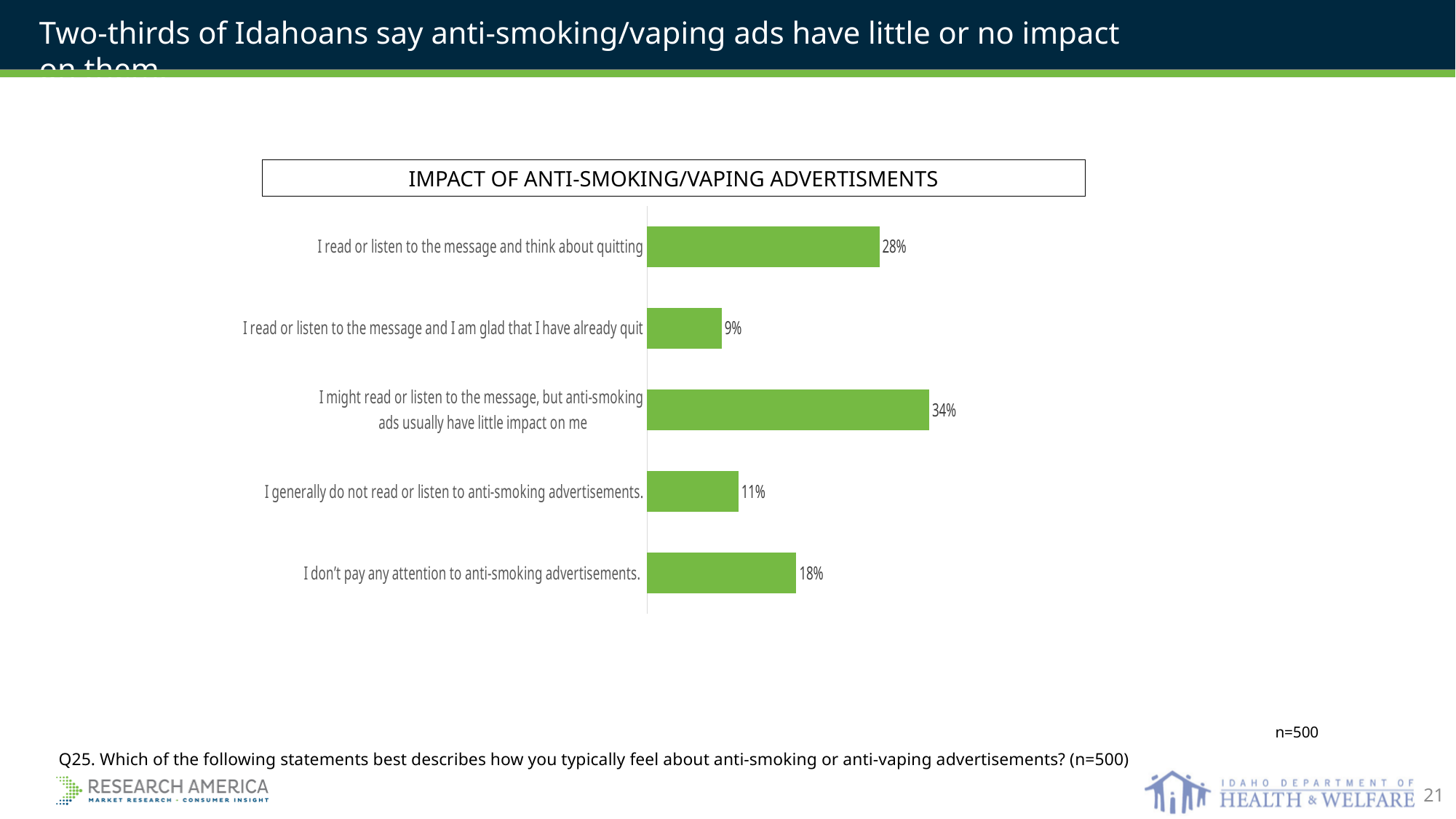
What percentage of respondents say they might read or listen to the message, but anti-smoking ads usually have little impact on them? 34% What is the title of the chart? IMPACT OF ANTI-SMOKING/VAPING ADVERTISMENTS Which statement has the highest percentage of respondents? I might read or listen to the message, but anti-smoking ads usually have little impact on me Which is larger: the percentage who don't pay any attention to anti-smoking advertisements or the percentage who generally do not read or listen to them? I don't pay any attention to anti-smoking advertisements. How many statements (categories) are shown in the chart? 5 Which statement has the lowest percentage of respondents? I read or listen to the message and I am glad that I have already quit What percentage of respondents say they read or listen to the message and are glad they have already quit? 9% What percentage of respondents say they generally do not read or listen to anti-smoking advertisements? 11% What percentage of respondents say they don't pay any attention to anti-smoking advertisements? 18% What percentage of respondents say they read or listen to the message and think about quitting? 28% What is the difference in percentage points between those who say ads have little impact on them (34%) and those who think about quitting (28%)? 6 What type of chart is shown on the slide? Bar chart